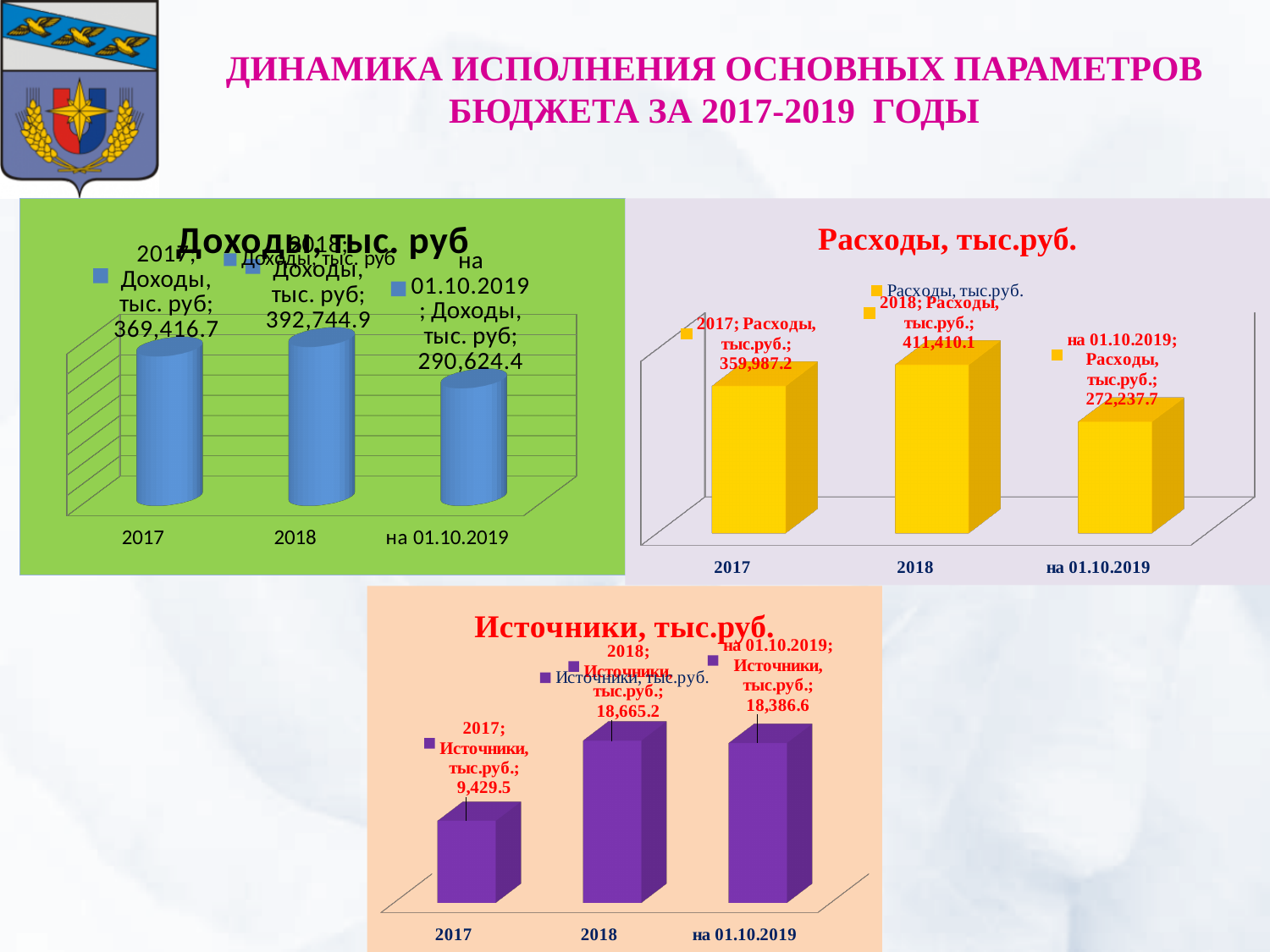
In the 'Доходы, тыс. руб' chart, what is the value for 2018? 392,744.9 In the 'Доходы, тыс. руб' chart, which category has the highest value? 2018 In the 'Расходы, тыс.руб.' chart, which category has the lowest value? на 01.10.2019 In the 'Расходы, тыс.руб.' chart, what is the difference between the 2018 and 2017 values? 51,422.9 In the 'Доходы, тыс. руб' chart, what is the difference between the 2018 and 2017 values? 23,328.2 In the 'Источники, тыс.руб.' chart, which is larger, the value for 2018 or the value for на 01.10.2019? 2018 In the 'Расходы, тыс.руб.' chart, what is the value for 2017? 359,987.2 How many categories are shown in the 'Расходы, тыс.руб.' chart? 3 In the 'Источники, тыс.руб.' chart, what is the value for 2017? 9,429.5 In the 'Доходы, тыс. руб' chart, what is the value for на 01.10.2019? 290,624.4 In the 'Источники, тыс.руб.' chart, what is the difference between the 2018 and 2017 values? 9,235.7 What kind of chart is the 'Источники, тыс.руб.' chart? bar chart